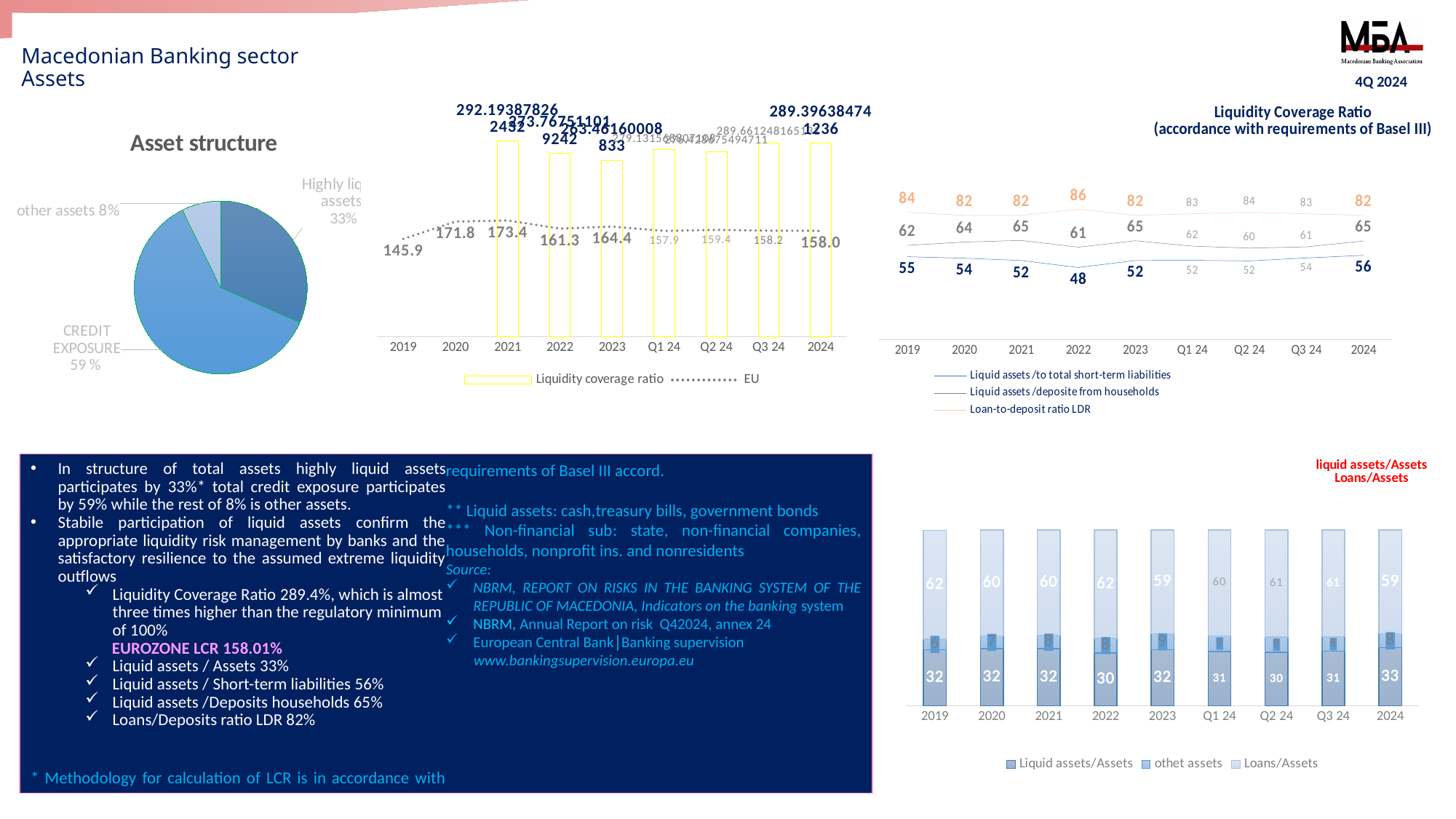
In the middle Liquidity coverage ratio chart, what is the EU value for 2019? 145.9 In the Liquidity Coverage Ratio (Basel III) line chart, what is the difference between Liquid assets/deposits from households and Liquid assets/to total short-term liabilities in 2024? 9 In the Asset structure pie chart, which slice is the largest? CREDIT EXPOSURE In the middle Liquidity coverage ratio chart, how many series does the legend list? 2 In the bottom-right stacked bar chart, what is the Loans/Assets value for 2023? 59 In the Liquidity Coverage Ratio (Basel III) line chart, what is the value of Liquid assets/to total short-term liabilities for 2022? 48 What kind of chart is the Asset structure chart? Pie chart In the Asset structure pie chart, what share is other assets? 8% In the Asset structure pie chart, what share is credit exposure? 59 % In the middle Liquidity coverage ratio chart, what is the EU value for 2024? 158.0 In the Liquidity Coverage Ratio (Basel III) line chart, what is the Loan-to-deposit ratio LDR for 2024? 82 In the middle Liquidity coverage ratio chart, which year has the highest EU value? 2021